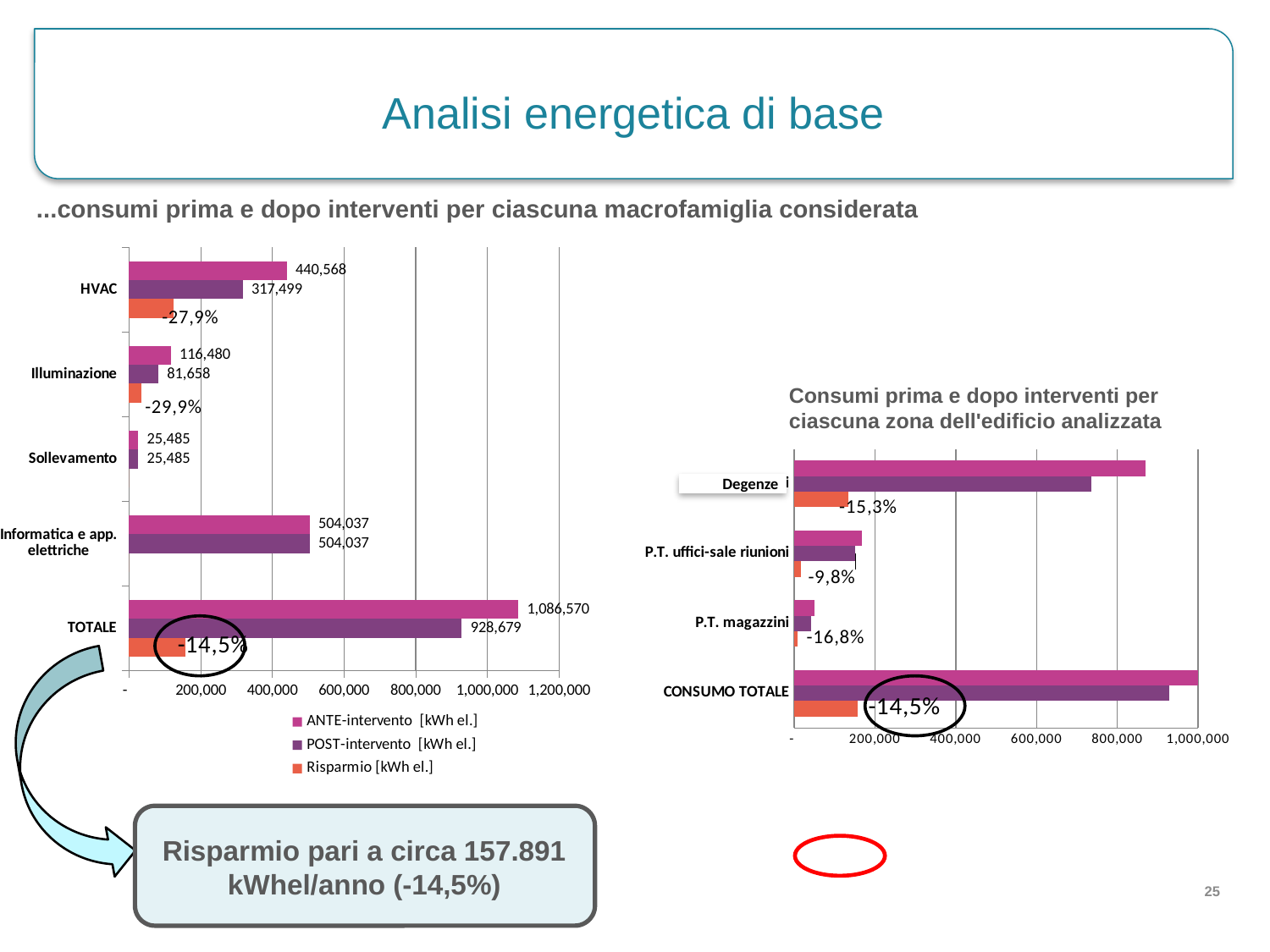
In the chart titled 'Consumi prima e dopo interventi per ciascuna zona dell'edificio analizzata', is the ANTE-intervento value for Degenze greater or less than 800,000? greater In the left chart, what is the POST-intervento value for TOTALE? 928,679 In the left chart, what is the ANTE-intervento value for HVAC? 440,568 In the left chart, what is the difference between the ANTE-intervento and POST-intervento values for TOTALE? 157,891 In the left chart, excluding TOTALE, which category has the lowest ANTE-intervento value? Sollevamento In the left chart, what is the POST-intervento value for Illuminazione? 81,658 In the left chart, excluding TOTALE, which category has the highest ANTE-intervento value? Informatica e app. elettriche What type of chart is the left chart on the slide? Bar chart In the left chart, what percentage saving is shown for HVAC? -27,9% In the left chart, how many series does the legend list? 3 In the chart titled 'Consumi prima e dopo interventi per ciascuna zona dell'edificio analizzata', what percentage saving is shown for P.T. magazzini? -16,8% In the chart titled 'Consumi prima e dopo interventi per ciascuna zona dell'edificio analizzata', how many categories are shown on the vertical axis? 4